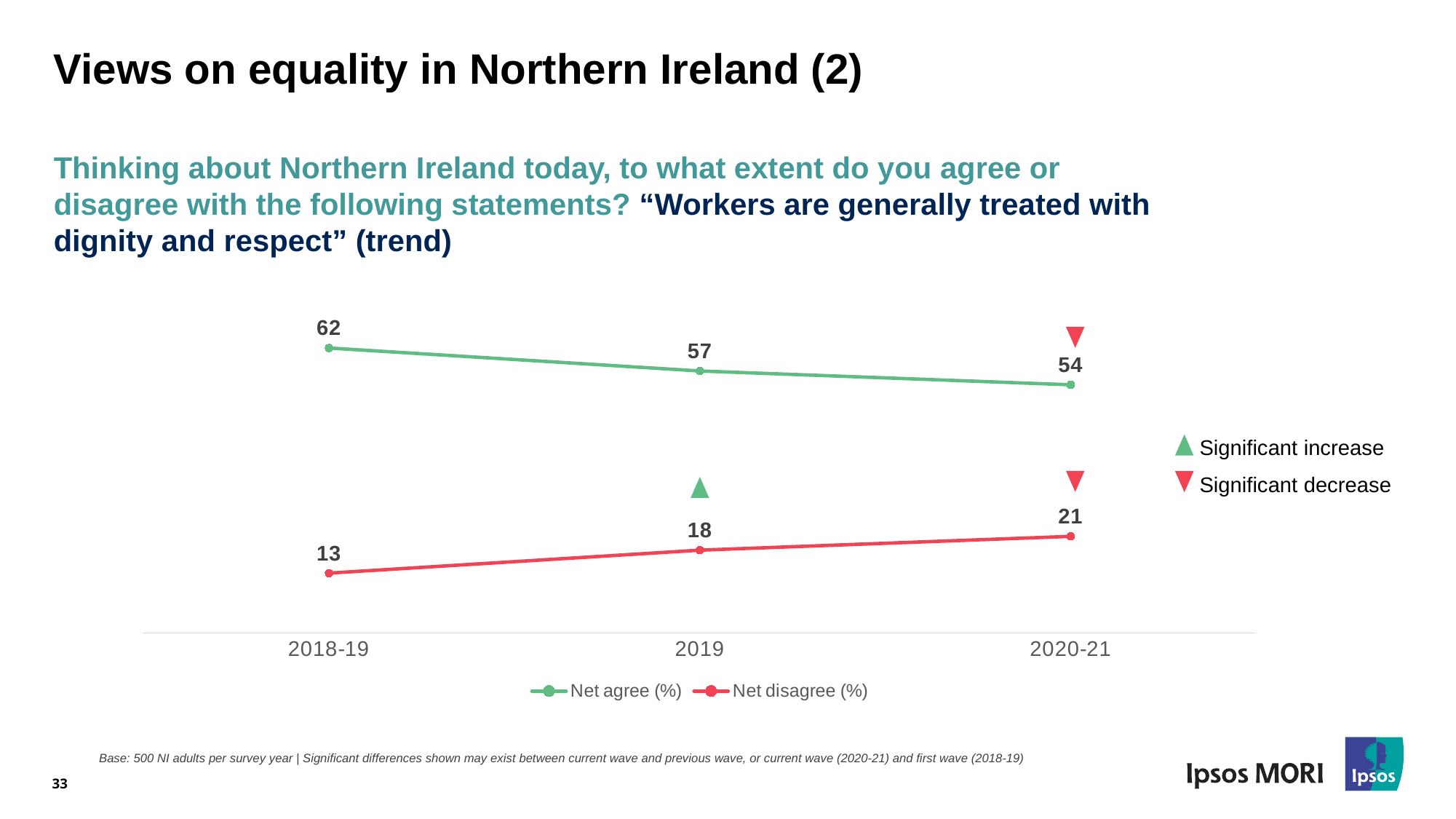
Which is larger in 2019: Net agree (%) or Net disagree (%)? Net agree (%) How many series does the legend list? 2 What is the Net agree (%) value for 2018-19? 62 In which survey year is Net disagree (%) highest? 2020-21 What is the difference between Net disagree (%) in 2019 and 2018-19? 5 Does Net agree (%) rise or fall from 2018-19 to 2020-21? Fall What is the difference between Net agree (%) in 2018-19 and 2020-21? 8 What kind of chart is shown on the slide? Line chart What is the Net agree (%) value for 2019? 57 In which survey year is Net agree (%) lowest? 2020-21 What is the Net disagree (%) value for 2020-21? 21 How many survey years are plotted on the x axis? 3